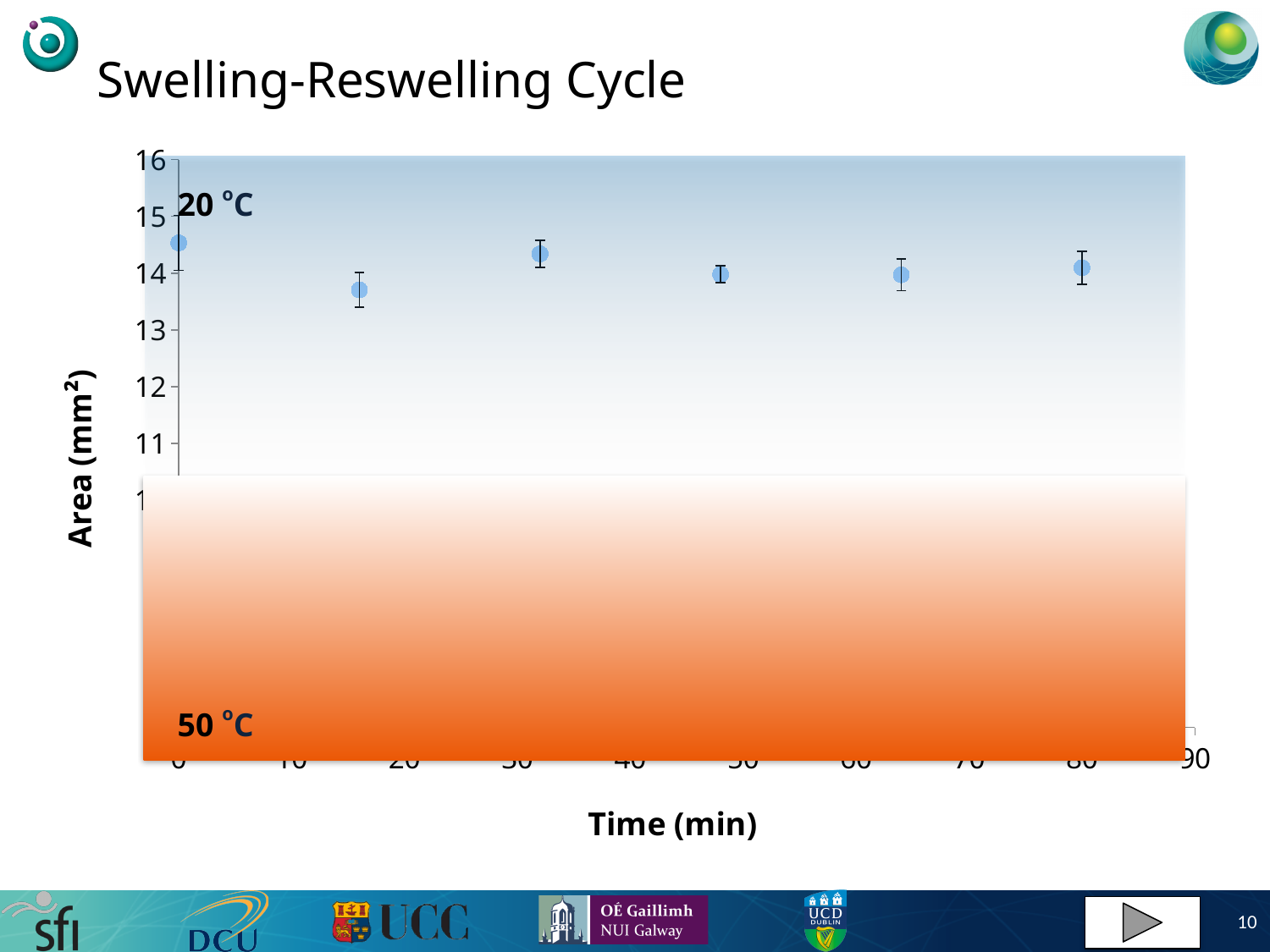
Is the area value at 0 min greater or less than 14? greater Which has a larger area value: the point at 0 min or the second point (around 16 min)? the point at 0 min What is the label of the y axis? Area (mm²) What is the label of the x axis? Time (min) Which data point has the highest area value? the point at 0 min What kind of chart is shown on the slide? scatter chart How many data points are plotted in the visible (blue) region of the chart? 6 Is the area value of the third data point (around 32 min) greater or less than 14? greater Is the area value of the second data point (around 16 min) greater or less than 14? less Which data point has the lowest area value? the second point (around 16 min)